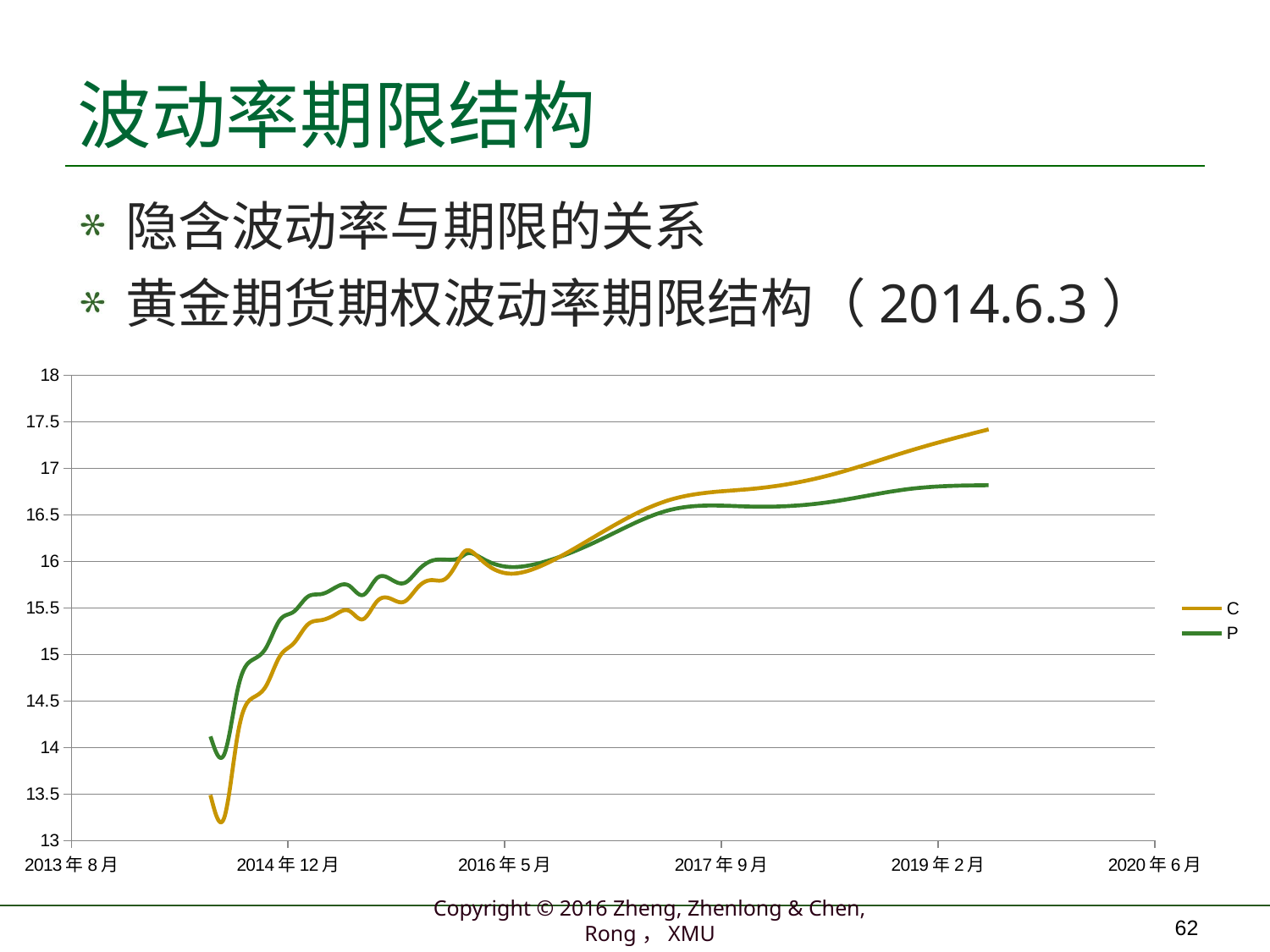
Do the values of series P generally rise or fall from left to right along the x axis? rise What are the names of the two series in the legend? C and P At the right end of the chart, which series has the higher value, C or P? C Do the values of series C generally rise or fall from left to right along the x axis? rise At the left end of the chart, which series has the higher value, C or P? P What kind of chart is shown on the slide? line chart Which colour is used for series C? yellow (gold) How many series does the legend list? 2 Is the value of series P at its right end greater or less than 17? less Which series reaches the lowest value on the chart? C Is the value of series C at its right end greater or less than 17? greater Which series reaches the highest value on the chart? C